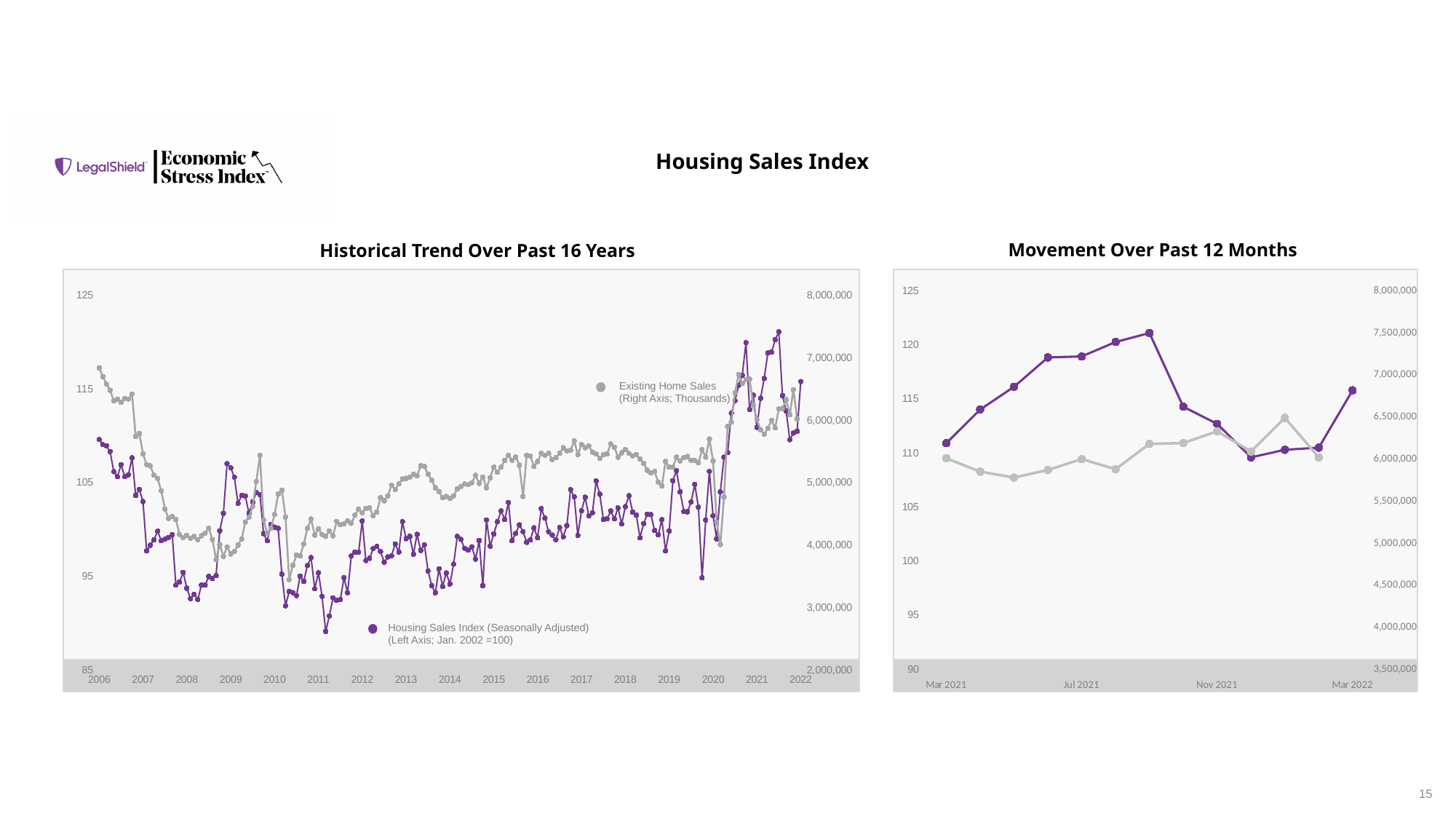
On the 'Historical Trend Over Past 16 Years' chart, which axis does the Existing Home Sales series use? Right axis How many series does the legend list on the 'Historical Trend Over Past 16 Years' chart? 2 On the 'Movement Over Past 12 Months' chart, is the Housing Sales Index value for Nov 2021 greater or less than 115? less On the 'Movement Over Past 12 Months' chart, how many monthly points are plotted for the Housing Sales Index? 13 What kind of chart is the 'Movement Over Past 12 Months' chart? Line chart On the 'Historical Trend Over Past 16 Years' chart, what base period is the Housing Sales Index set to 100? Jan. 2002 On the 'Movement Over Past 12 Months' chart, is the Housing Sales Index value for Jul 2021 greater or less than 115? greater On the 'Movement Over Past 12 Months' chart, which is larger: the Housing Sales Index in Jul 2021 or in Nov 2021? Jul 2021 On the 'Historical Trend Over Past 16 Years' chart, is the Existing Home Sales value at the start of 2006 greater or less than 6,000,000? greater What kind of chart is the 'Historical Trend Over Past 16 Years' chart? Line chart On the 'Movement Over Past 12 Months' chart, does the Housing Sales Index rise or fall from Mar 2021 to Sep 2021? Rise On the 'Movement Over Past 12 Months' chart, in which month does the Housing Sales Index reach its highest value? Sep 2021